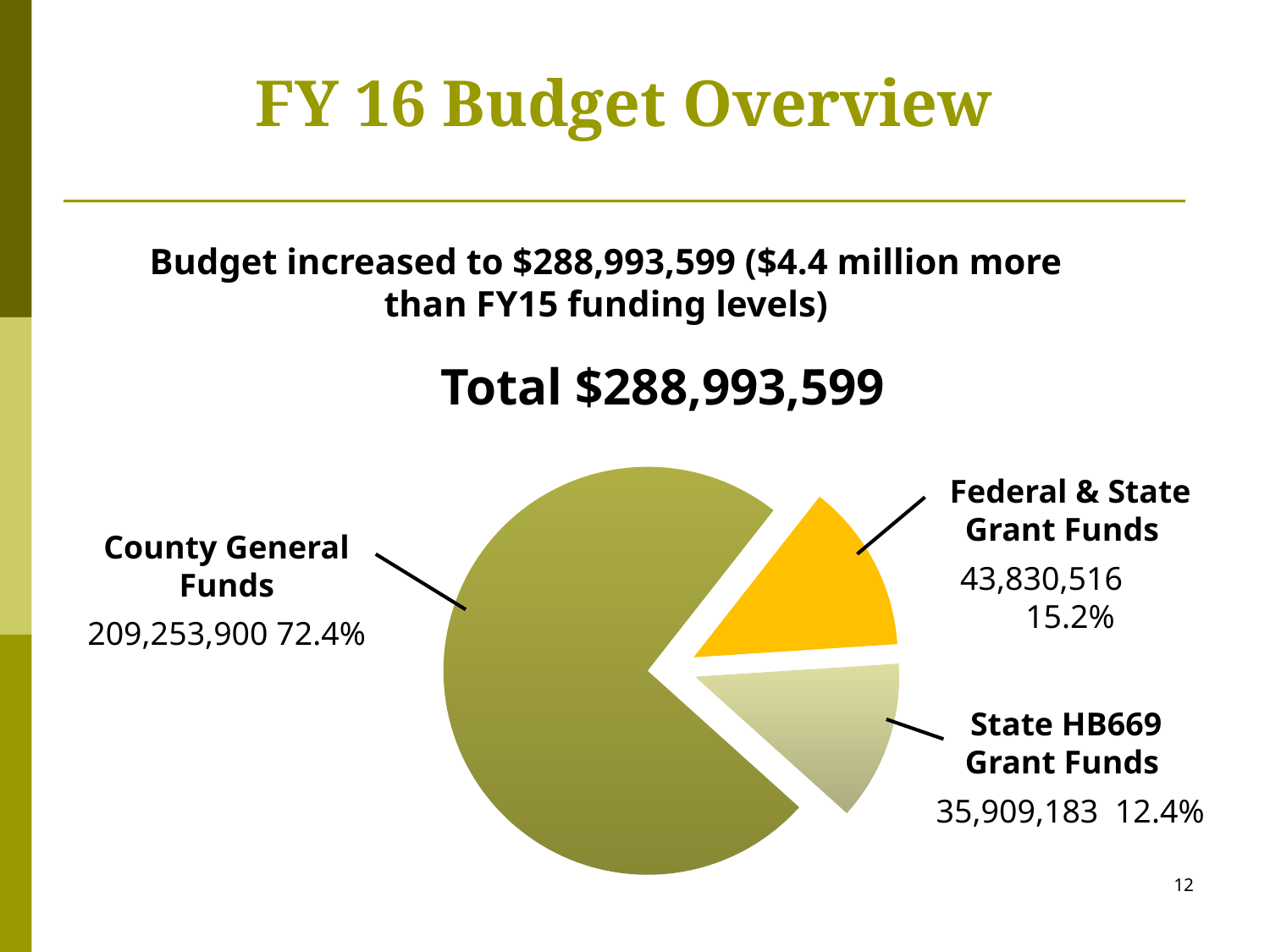
What is the value for Federal & State Grant Funds? 43,830,516 How many slices does the pie chart have? 3 Which slice of the pie chart is the smallest? State HB669 Grant Funds What share of the pie is State HB669 Grant Funds? 12.4% What share of the pie is County General Funds? 72.4% Which slice of the pie chart is the largest? County General Funds What is the total of all slices in the pie chart? $288,993,599 What is the value for State HB669 Grant Funds? 35,909,183 What is the difference between Federal & State Grant Funds and State HB669 Grant Funds? 7,921,333 Which is larger, Federal & State Grant Funds or State HB669 Grant Funds? Federal & State Grant Funds What kind of chart is shown on the slide? Pie chart What is the value for County General Funds? 209,253,900